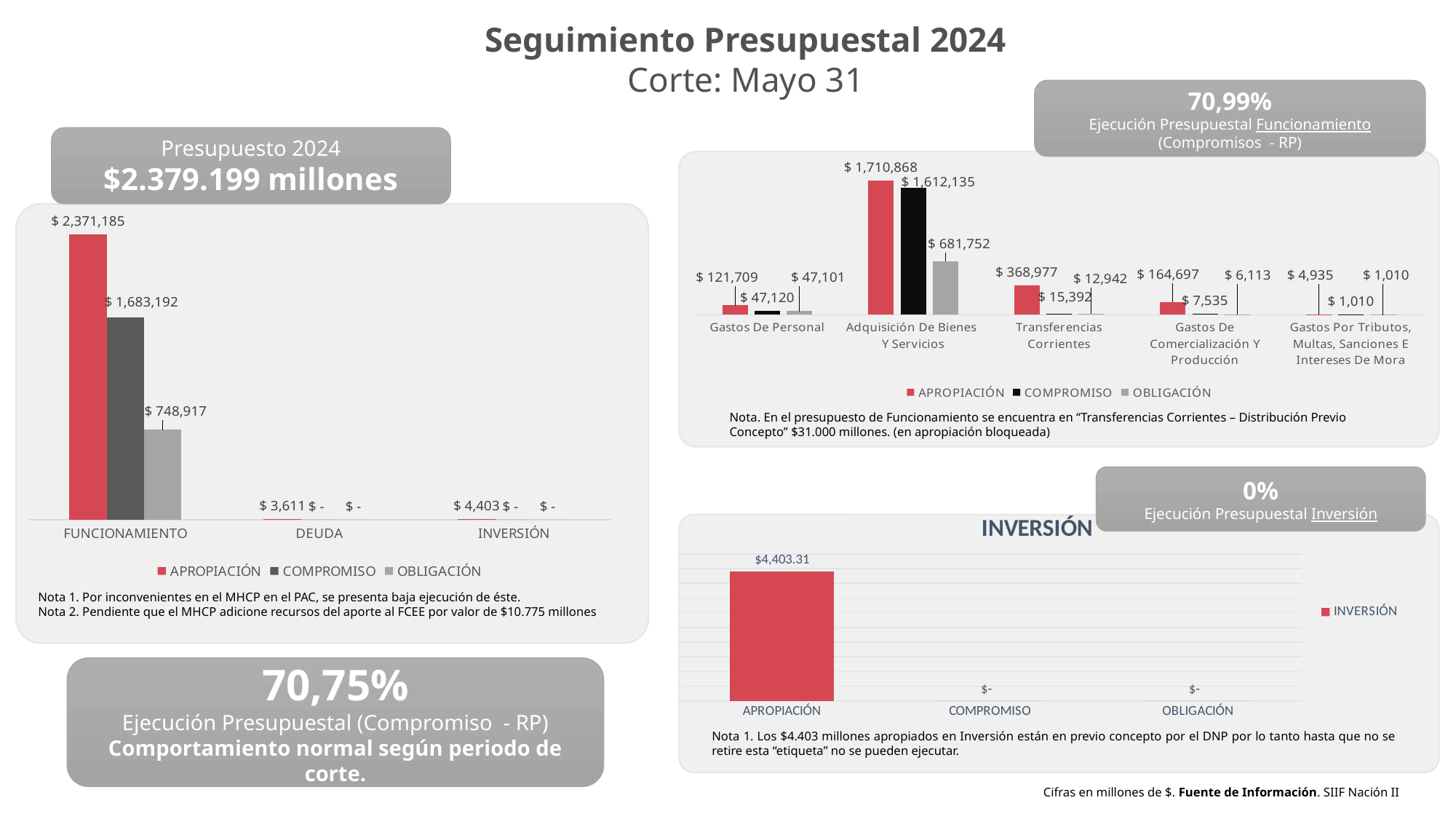
In the chart on the left of the slide, what kind of chart is it? Bar chart In the chart at the top right of the slide, which category has the highest APROPIACIÓN value? Adquisición De Bienes Y Servicios In the chart on the left of the slide, what is the OBLIGACIÓN value for FUNCIONAMIENTO? $ 748,917 In the chart on the left of the slide, what is the difference between the APROPIACIÓN and COMPROMISO values for FUNCIONAMIENTO? $ 687,993 In the chart at the top right of the slide, what is the OBLIGACIÓN value for Transferencias Corrientes? $ 12,942 In the chart at the top right of the slide, what is the COMPROMISO value for Adquisición De Bienes Y Servicios? $ 1,612,135 In the chart on the left of the slide, what is the APROPIACIÓN value for DEUDA? $ 3,611 In the INVERSIÓN chart at the bottom right of the slide, what is the APROPIACIÓN value? $4,403.31 In the chart at the top right of the slide, how many categories are shown on the x axis? 5 In the chart on the left of the slide, what is the APROPIACIÓN value for FUNCIONAMIENTO? $ 2,371,185 In the chart on the left of the slide, how many series does the legend list? 3 In the chart at the top right of the slide, which category has the lowest APROPIACIÓN value? Gastos Por Tributos, Multas, Sanciones E Intereses De Mora